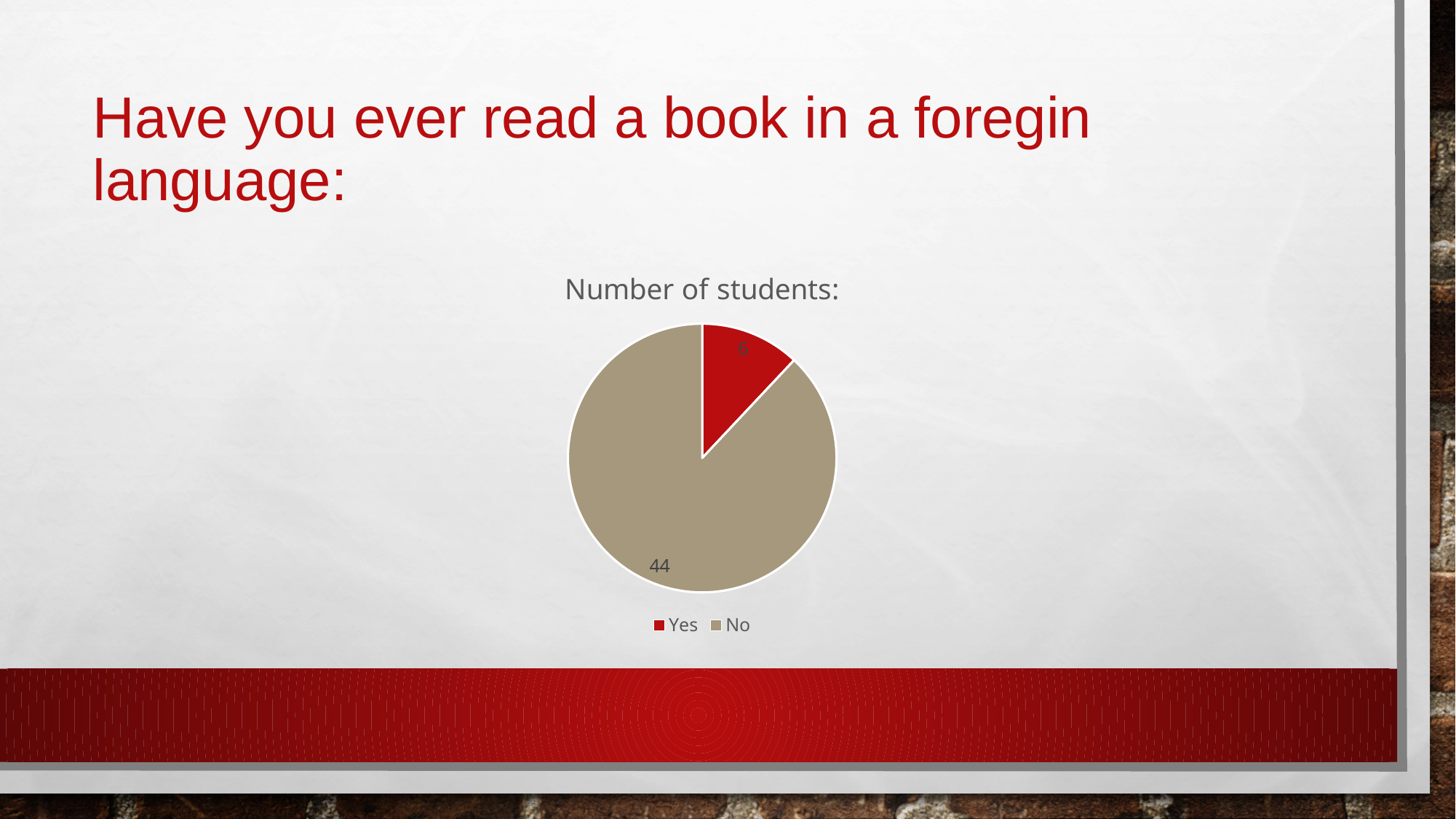
Which is larger, the number of Yes answers or the number of No answers? No What is the total number of students represented in the pie chart? 50 What kind of chart is shown on the slide? pie chart What share of the pie does the Yes slice represent? 12% Which answer has the largest slice of the pie? No How many students answered No? 44 What colour is the Yes slice? red Which answer has the smallest slice of the pie? Yes How many students answered Yes? 6 What is the title of the chart? Number of students: How many categories does the pie chart have? 2 How many more students answered No than Yes? 38